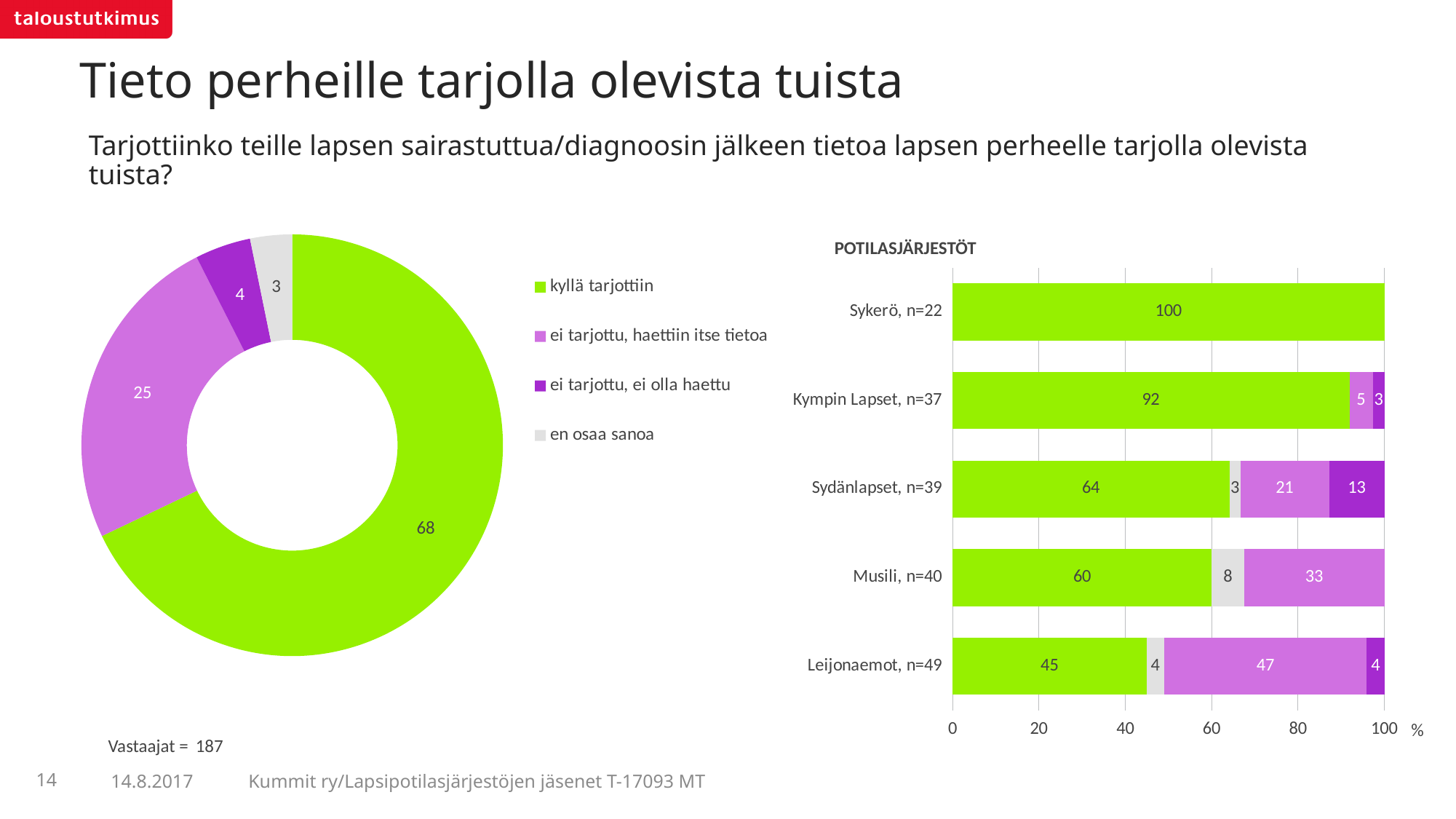
In the POTILASJÄRJESTÖT chart, which organisation has the highest green 'kyllä tarjottiin' value? Sykerö, n=22 In the donut chart on the left, what is the value for 'kyllä tarjottiin'? 68 In the POTILASJÄRJESTÖT chart, is the green 'kyllä tarjottiin' value for Musili, n=40 larger or smaller than that for Kympin Lapset, n=37? smaller In the POTILASJÄRJESTÖT chart, how many organisations are shown? 5 In the donut chart on the left, how many categories does the legend list? 4 In the POTILASJÄRJESTÖT chart, what is the light purple 'ei tarjottu, haettiin itse tietoa' value for Leijonaemot, n=49? 47 In the POTILASJÄRJESTÖT chart, what is the green 'kyllä tarjottiin' value for Sydänlapset, n=39? 64 In the donut chart on the left, what is the difference between 'kyllä tarjottiin' and 'ei tarjottu, haettiin itse tietoa'? 43 In the POTILASJÄRJESTÖT chart, which organisation has the lowest green 'kyllä tarjottiin' value? Leijonaemot, n=49 What kind of chart is the POTILASJÄRJESTÖT chart? Stacked bar chart In the donut chart on the left, which category has the smallest value? en osaa sanoa In the donut chart on the left, what is the value for 'ei tarjottu, haettiin itse tietoa'? 25